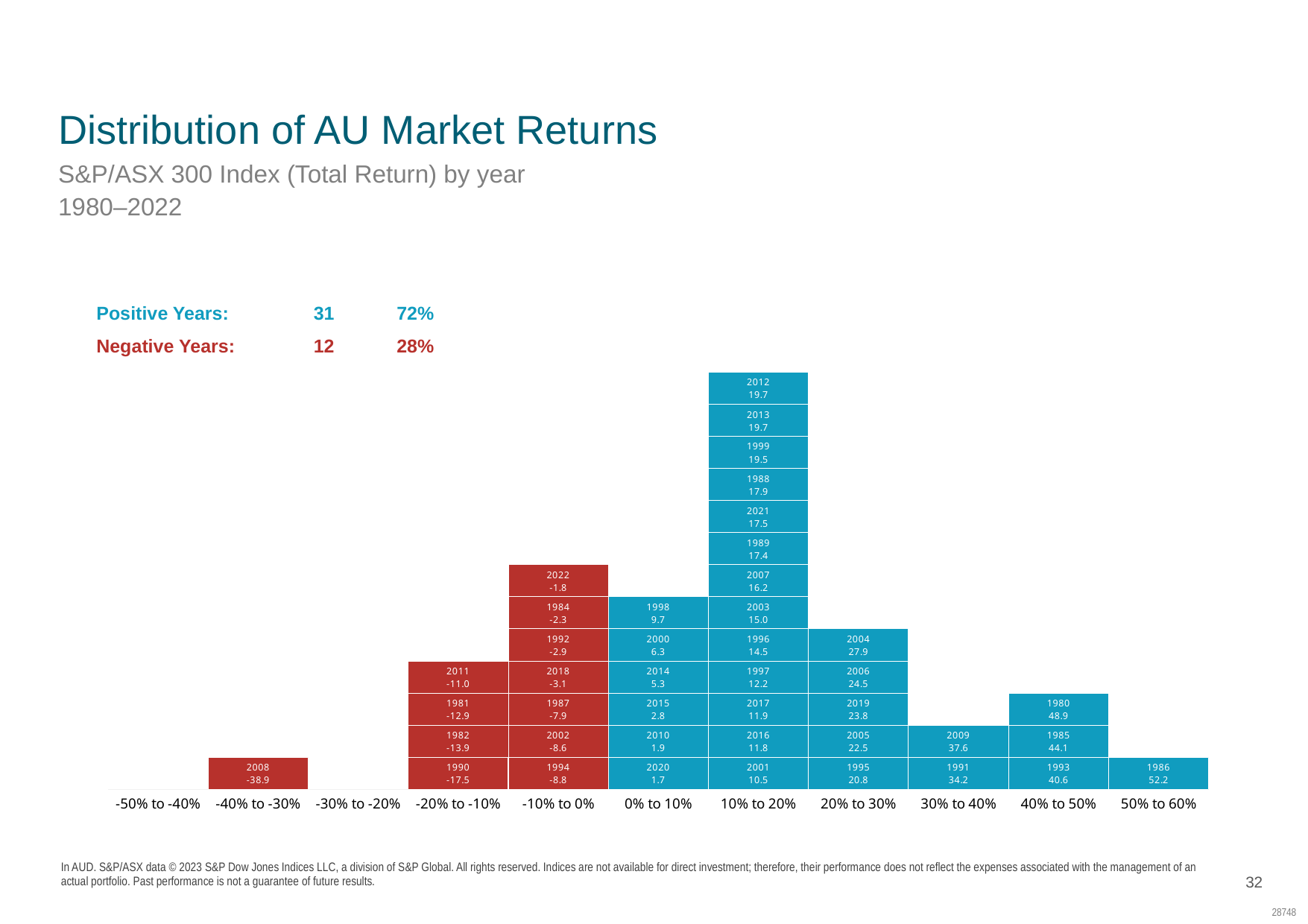
What was the return for 1986? 52.2 Which return bin contains the most years? 10% to 20% How many years fall in the -10% to 0% bin? 7 Which year had the higher return, 2009 or 1991? 2009 How many positive years does the slide report, and what percentage is that? 31, 72% What was the return for 2020? 1.7 What kind of chart is shown on the slide? bar chart What was the return for 1980? 48.9 How many years fall in the 10% to 20% bin? 13 What was the return for 2008? -38.9 How many years fall in the 40% to 50% bin? 3 What is the difference between the return for 1986 and the return for 1980? 3.3